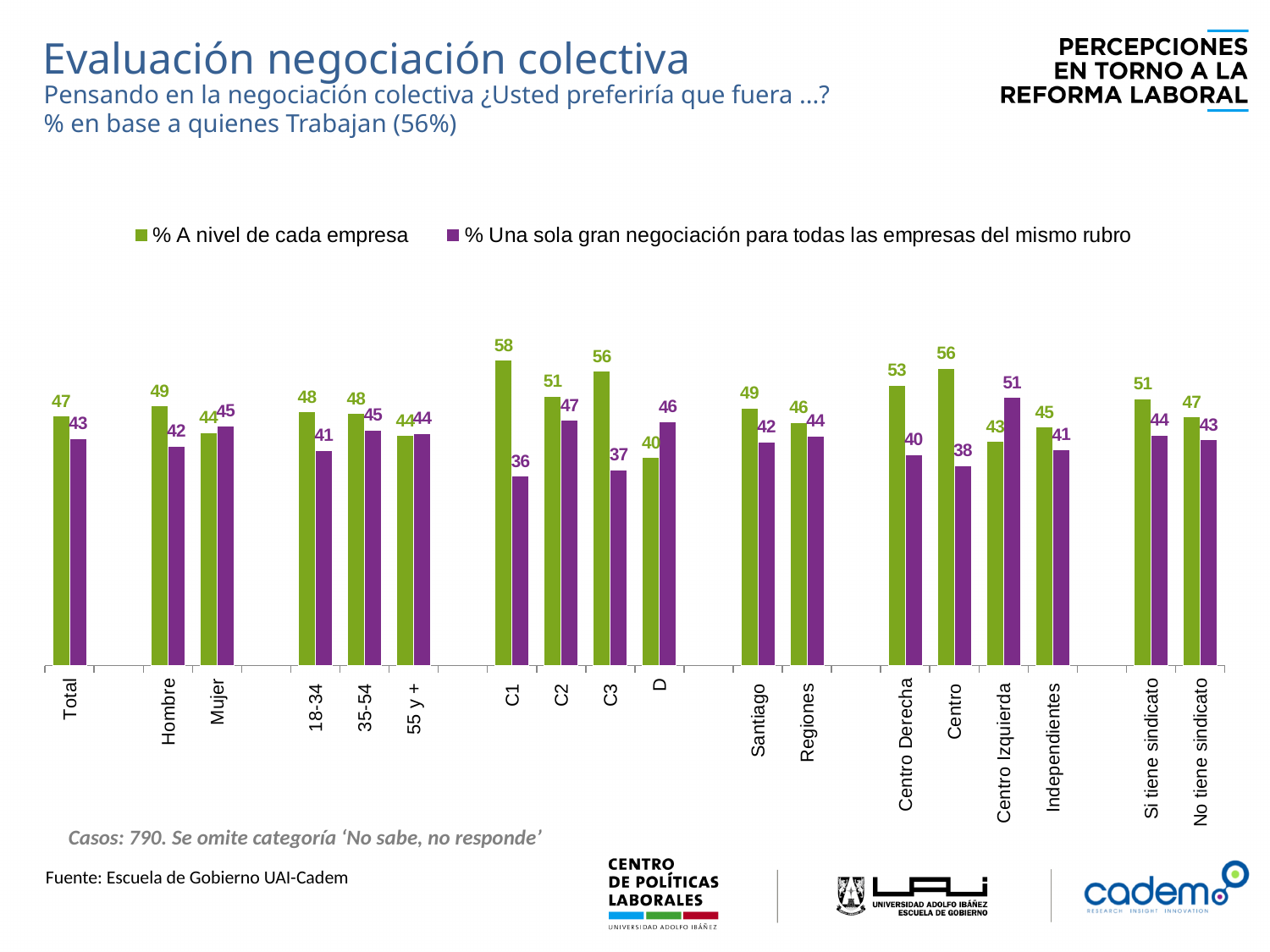
How many series does the legend list? 2 What kind of chart is shown on the slide? Bar chart For D, which series has the larger value? % Una sola gran negociación para todas las empresas del mismo rubro Which category has the highest value for "% A nivel de cada empresa"? C1 What is the difference between "% A nivel de cada empresa" for Centro and for Centro Izquierda? 13 What is the value of "% Una sola gran negociación para todas las empresas del mismo rubro" for Centro Izquierda? 51 Which category has the lowest value for "% A nivel de cada empresa"? D What is the value of "% A nivel de cada empresa" for C1? 58 What is the value of "% A nivel de cada empresa" for Total? 47 Which category has the lowest value for "% Una sola gran negociación para todas las empresas del mismo rubro"? C1 What is the difference between the two series for C1? 22 How many categories are shown on the x axis? 18